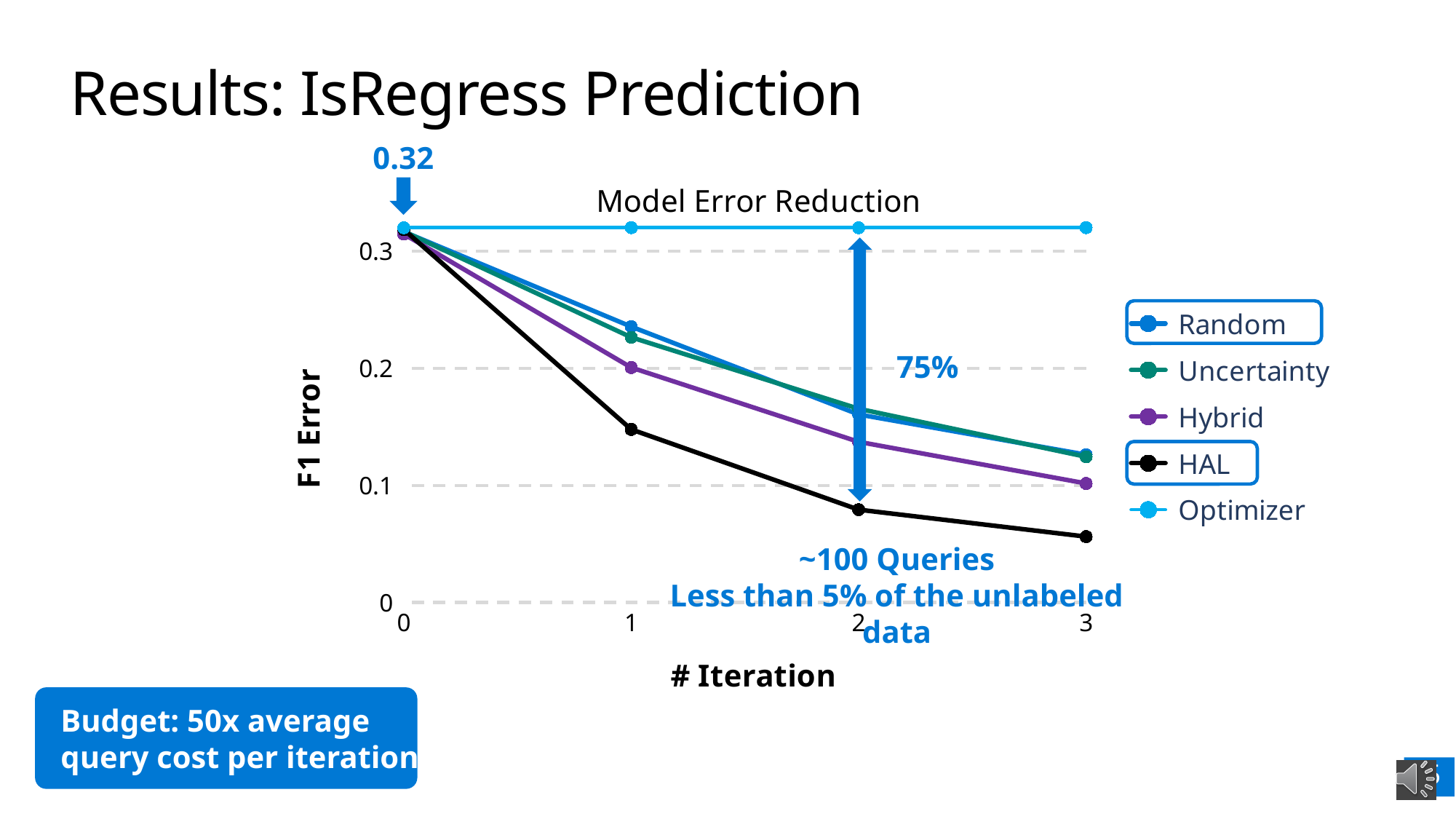
Which series has the lowest F1 error at iteration 3? HAL Is the F1 error for HAL at iteration 2 greater or less than 0.1? less What kind of chart is shown on the slide? line chart How many iteration points are plotted for each series? 4 What is the label of the x axis? # Iteration Is the F1 error for Random at iteration 1 greater or less than 0.2? greater What F1 error value is annotated at iteration 0? 0.32 How many series does the legend list? 5 What is the title of the chart? Model Error Reduction At iteration 2, which has the larger F1 error, Hybrid or HAL? Hybrid Which series has the highest F1 error at iteration 3? Optimizer Does the F1 error for HAL rise or fall as the iteration number increases? fall